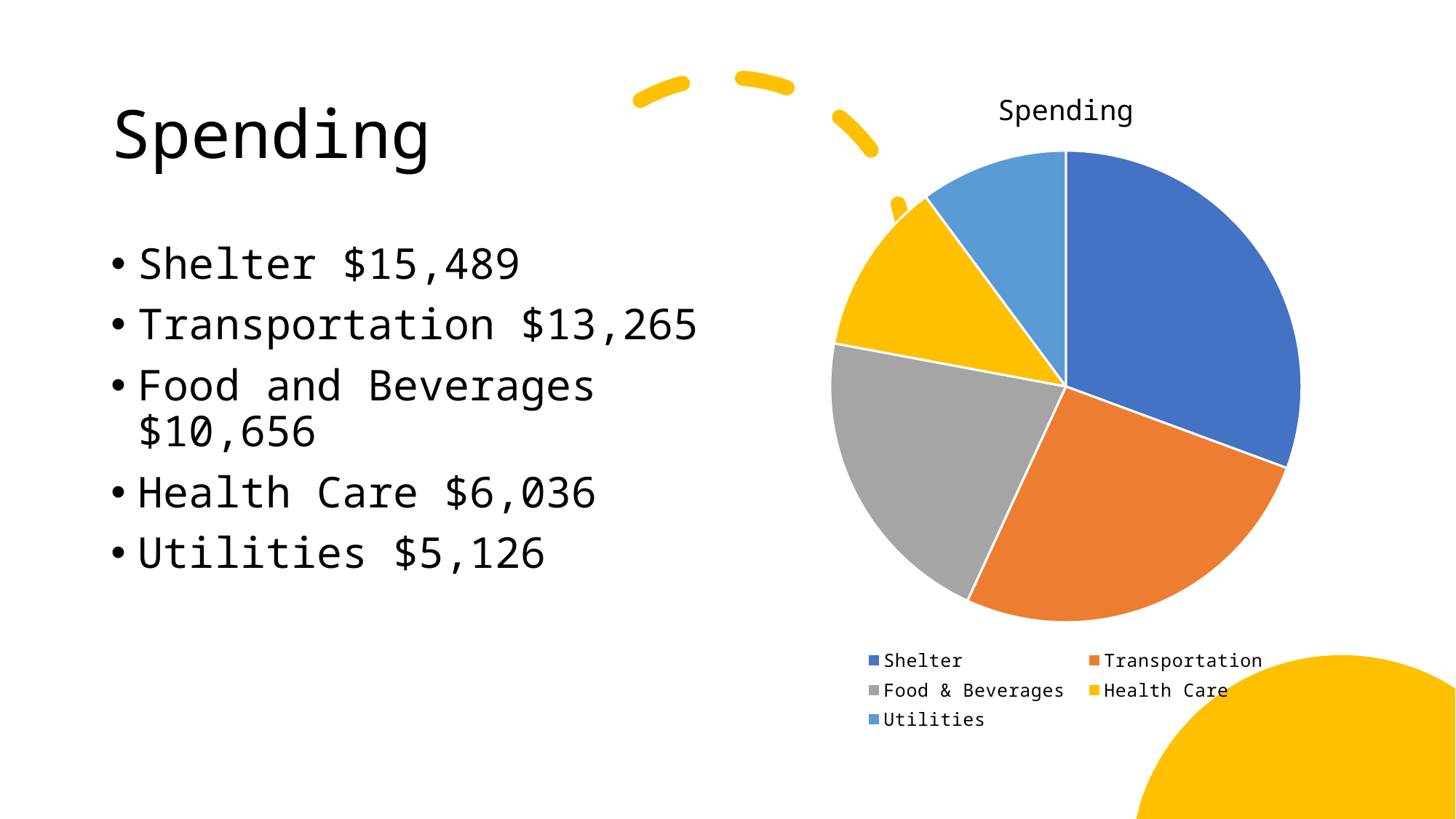
What is the difference between the Shelter and Transportation spending values? $2,224 What is the spending value for Health Care? $6,036 How many slices does the pie chart have? 5 What is the spending value for Utilities? $5,126 What is the title of the chart? Spending What kind of chart is shown on the slide? pie chart What is the spending value for Shelter? $15,489 How many entries does the chart legend list? 5 Which category has the smallest slice of the pie? Utilities Which is larger, the Transportation slice or the Food & Beverages slice? Transportation Which category has the largest slice of the pie? Shelter What colour is the Shelter slice in the pie chart? blue